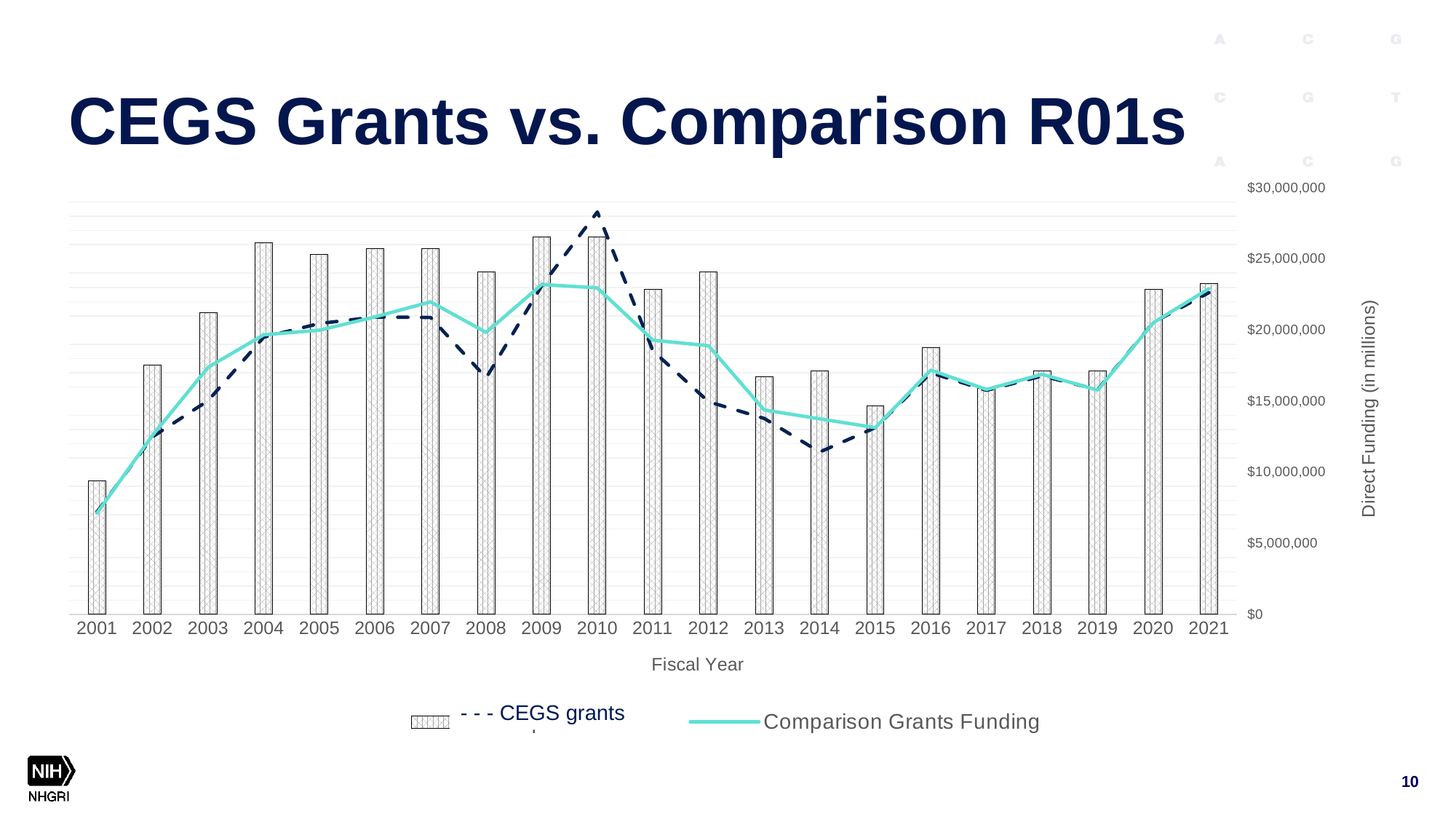
Is the bar for 2001 greater or less than $10,000,000? less How many fiscal years are shown on the x axis? 21 In which fiscal year is the Comparison Grants Funding line at its lowest? 2001 Is the bar for 2010 greater or less than $25,000,000? greater What kind of chart is shown on the slide? A combined bar and line chart What is the title of the y axis? Direct Funding (in millions) Is the Comparison Grants Funding value for 2009 greater or less than $20,000,000? greater Which bar is taller, 2004 or 2003? 2004 Do the bars rise or fall from 2010 to 2014? fall Which fiscal year has the lowest bar? 2001 In which fiscal year does the CEGS grants dashed line reach its highest point? 2010